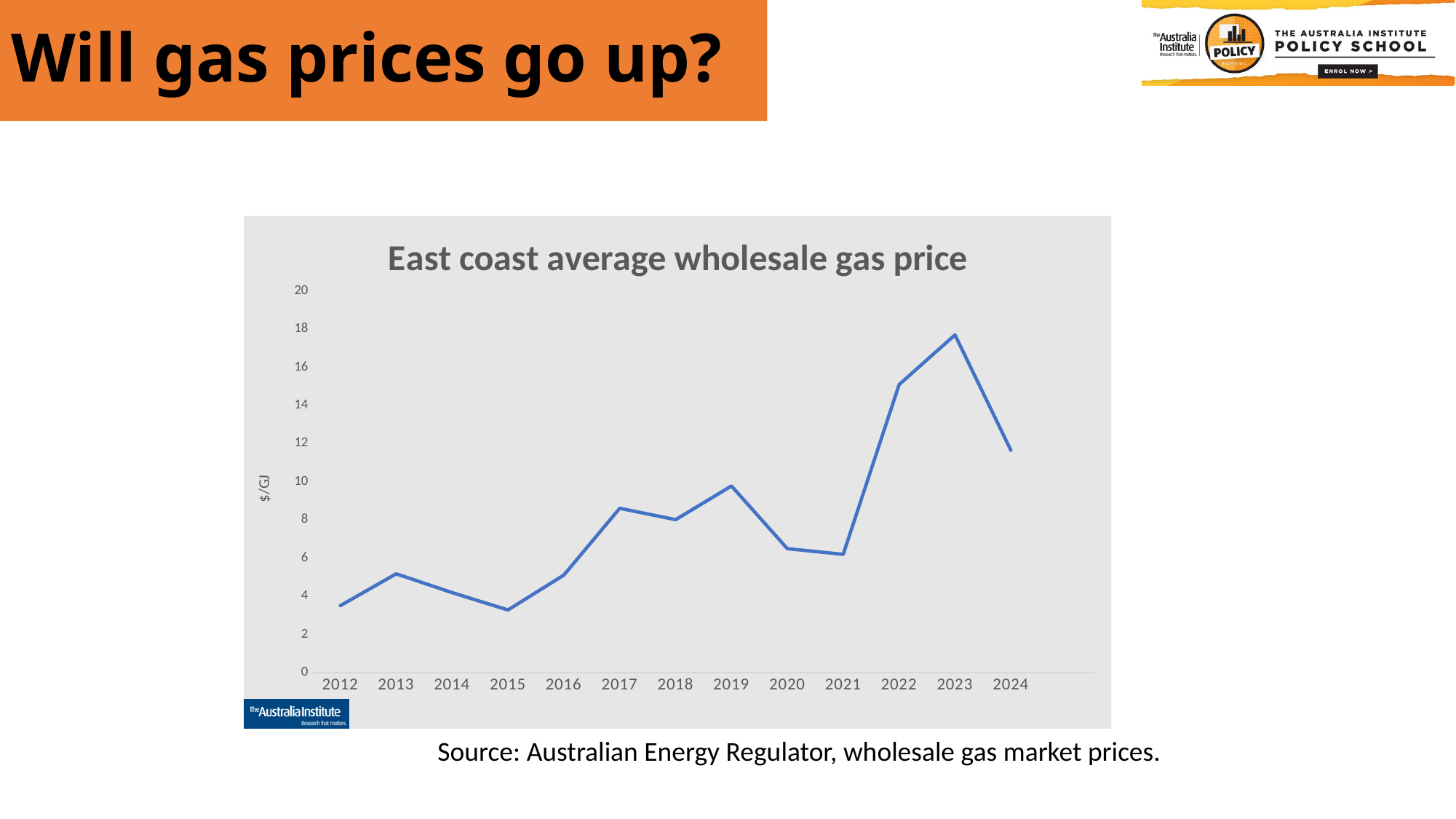
Which year has the higher gas price, 2022 or 2024? 2022 What kind of chart is shown on the slide? line chart Is the value for 2023 greater or less than 16? greater In which year is the east coast average wholesale gas price highest? 2023 How many years are plotted along the x axis of the chart? 13 What unit is shown on the vertical axis of the chart? $/GJ What is the title of the chart? East coast average wholesale gas price Is the value for 2021 greater or less than 8? less Does the gas price rise or fall between 2023 and 2024? fall Is the value for 2022 greater or less than 14? greater